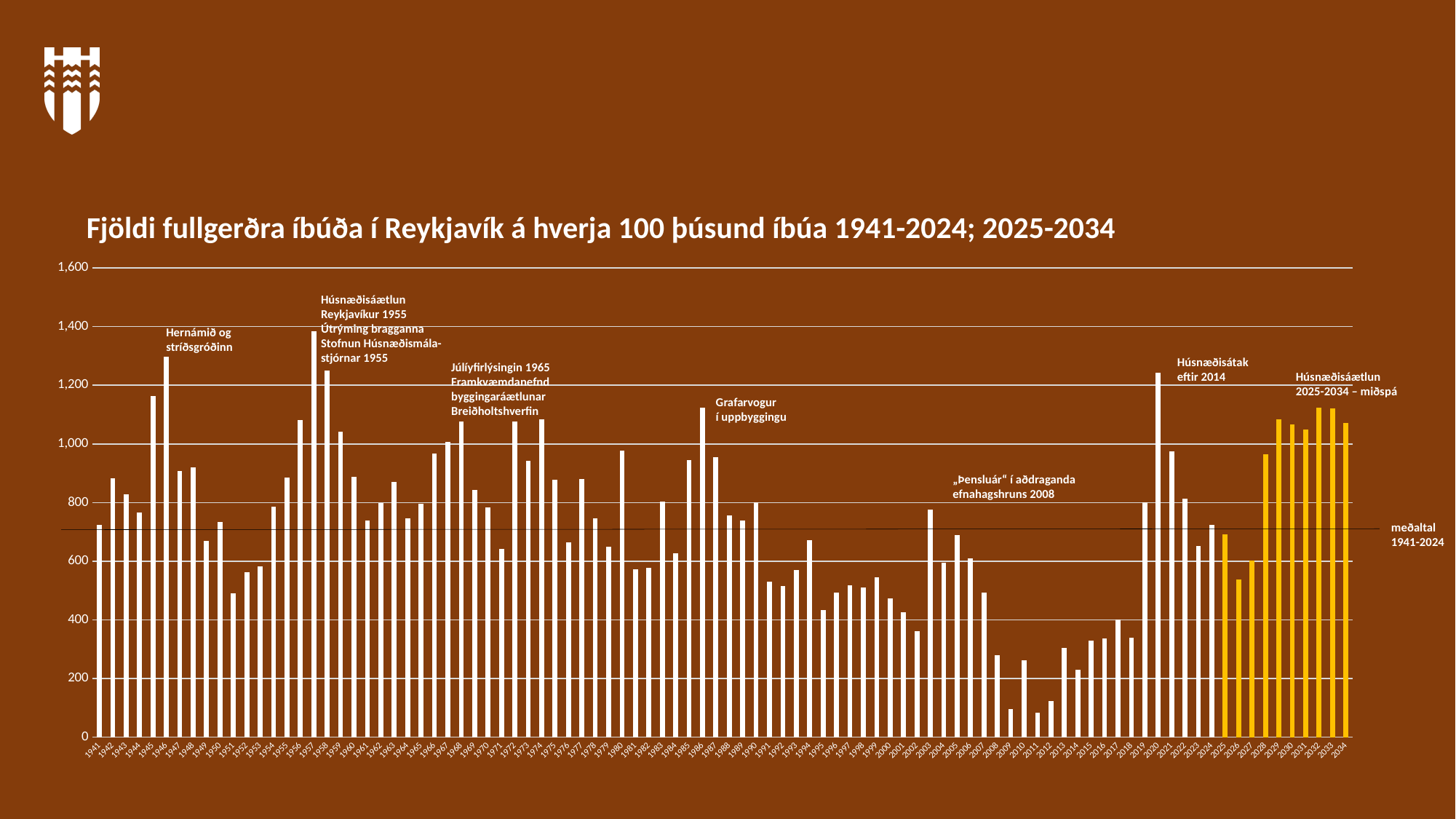
What label is given to the horizontal reference line on the right side of the chart? meðaltal 1941-2024 Which year has the highest bar in the chart? 1957 Is the value for 2026 greater or less than 600? less What kind of chart is shown on the slide? bar chart Is the value for 2008 greater or less than 400? less Which year has the larger value, 1957 or 2010? 1957 Is the value for 1957 greater or less than 1,200? greater How many years (bars) are plotted on the x axis, from 1941 to 2034? 94 What colour are the bars for the forecast years 2025-2034? yellow Do the values rise or fall from 2025 to 2029? rise